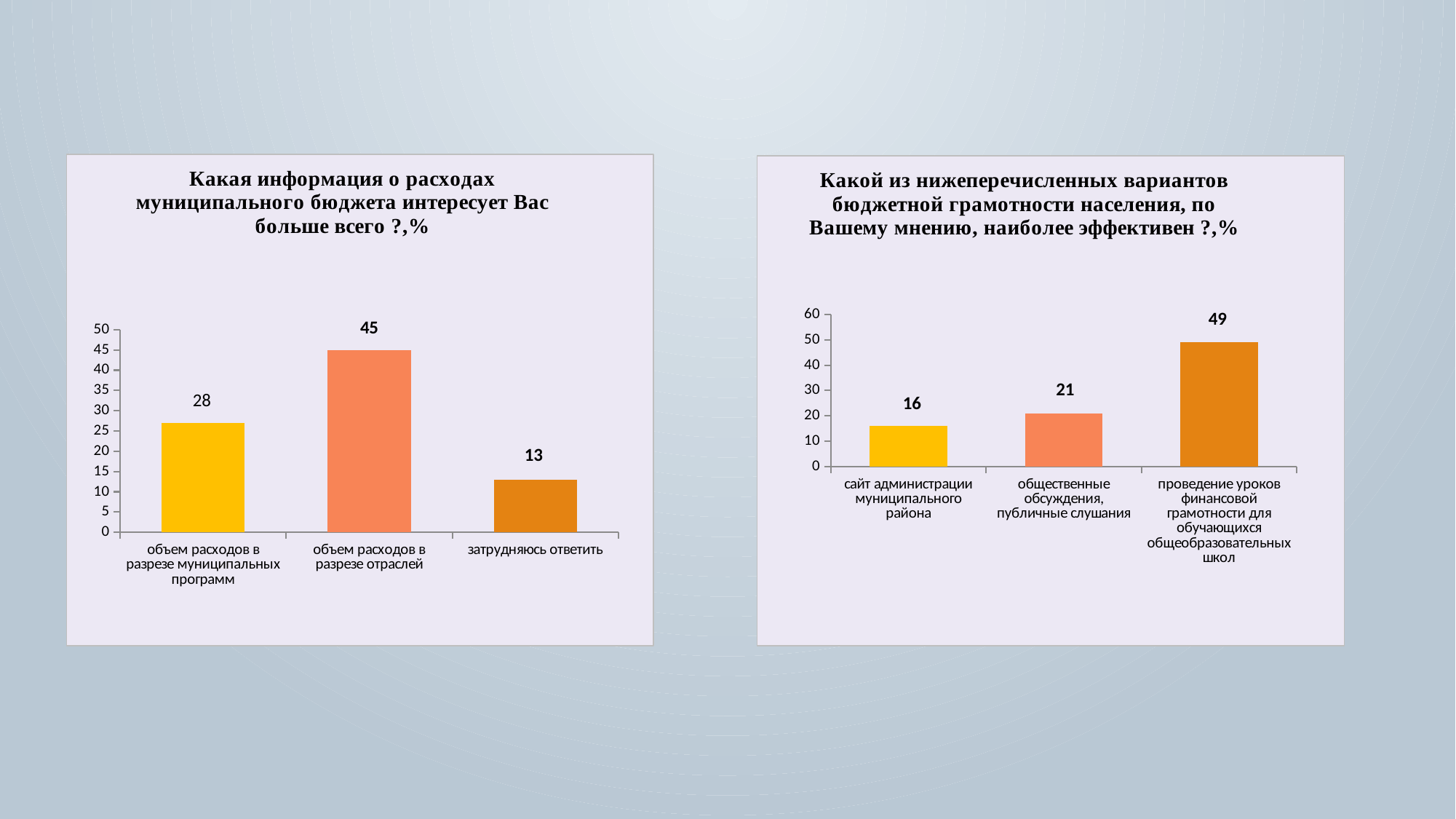
In the right chart, is the value for "общественные обсуждения, публичные слушания" greater or less than "сайт администрации муниципального района"? greater What kind of chart is the left chart? bar chart In the left chart, what is the value for "затрудняюсь ответить"? 13 In the left chart, how many categories are shown? 3 In the left chart, what is the value for "объем расходов в разрезе отраслей"? 45 In the right chart, do the values rise or fall from left to right along the x axis? rise In the right chart, what is the value for "проведение уроков финансовой грамотности для обучающихся общеобразовательных школ"? 49 In the left chart, what is the difference between "объем расходов в разрезе отраслей" and "объем расходов в разрезе муниципальных программ"? 17 In the right chart, which category has the lowest value? сайт администрации муниципального района In the right chart, what is the value for "сайт администрации муниципального района"? 16 In the left chart, which category has the highest value? объем расходов в разрезе отраслей In the right chart, what is the difference between "проведение уроков финансовой грамотности для обучающихся общеобразовательных школ" and "общественные обсуждения, публичные слушания"? 28